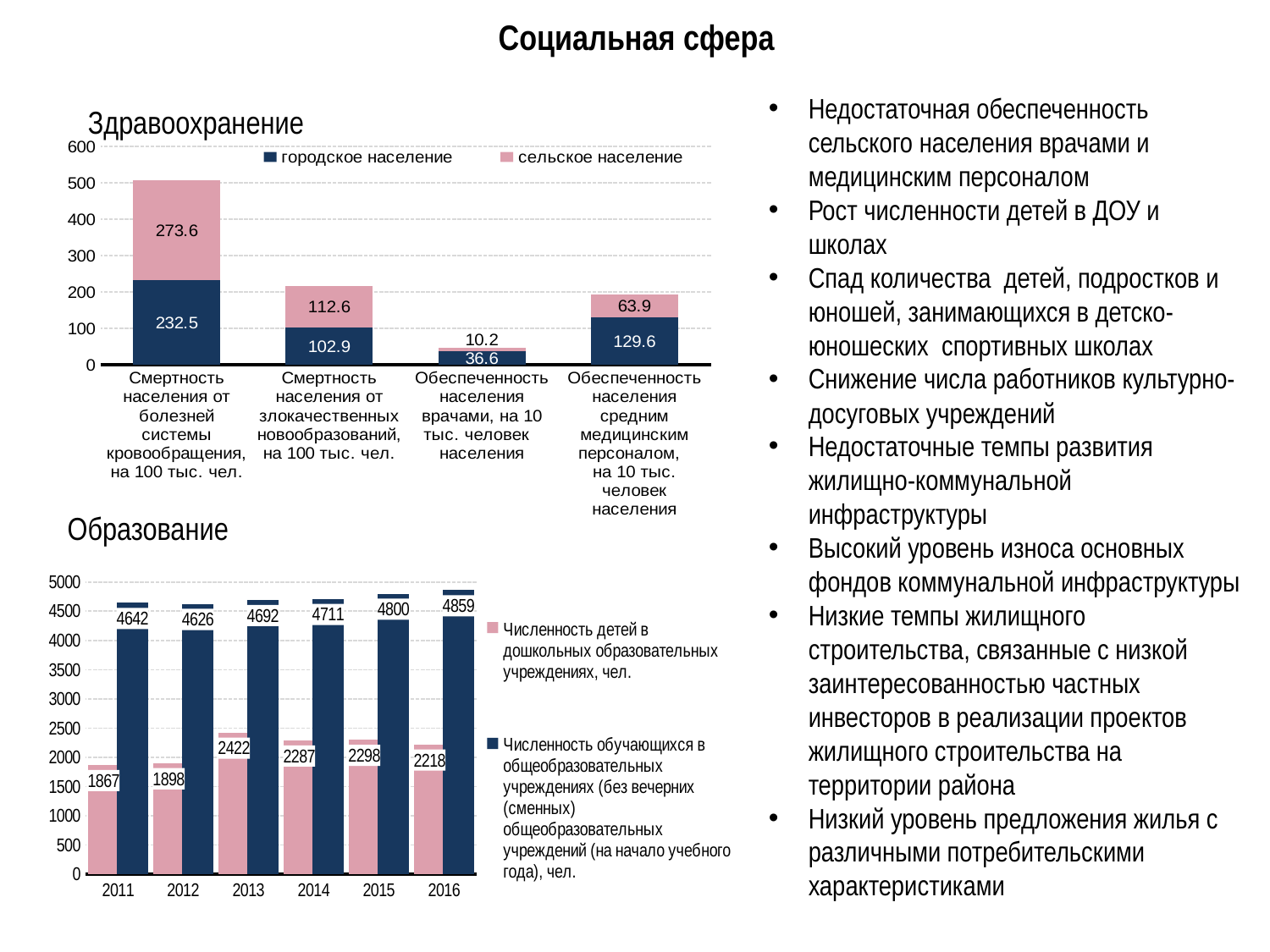
How many years are shown on the x axis of the 'Образование' chart? 6 In the 'Образование' chart, what is the difference between 'Численность обучающихся в общеобразовательных учреждениях' in 2016 and in 2011? 217 How many series does the legend of the 'Здравоохранение' chart list? 2 In the 'Здравоохранение' chart, which category has the lowest value for сельское население? Обеспеченность населения врачами, на 10 тыс. человек населения In the 'Образование' chart, what is the value for 'Численность обучающихся в общеобразовательных учреждениях' in 2014? 4711 In the 'Здравоохранение' chart, what is the total of the stacked bar for 'Смертность населения от злокачественных новообразований, на 100 тыс. чел.'? 215.5 What kind of chart is the 'Образование' chart? bar chart In the 'Здравоохранение' chart, what is the value for городское население for 'Смертность населения от болезней системы кровообращения, на 100 тыс. чел.'? 232.5 In the 'Здравоохранение' chart, what is the value for сельское население for 'Обеспеченность населения врачами, на 10 тыс. человек населения'? 10.2 In the 'Здравоохранение' chart, what is the difference between сельское население and городское население for 'Обеспеченность населения средним медицинским персоналом, на 10 тыс. человек населения'? 65.7 In the 'Образование' chart, does 'Численность обучающихся в общеобразовательных учреждениях' rise or fall from 2013 to 2016? rise In the 'Образование' chart, in which year is 'Численность детей в дошкольных образовательных учреждениях' highest? 2013